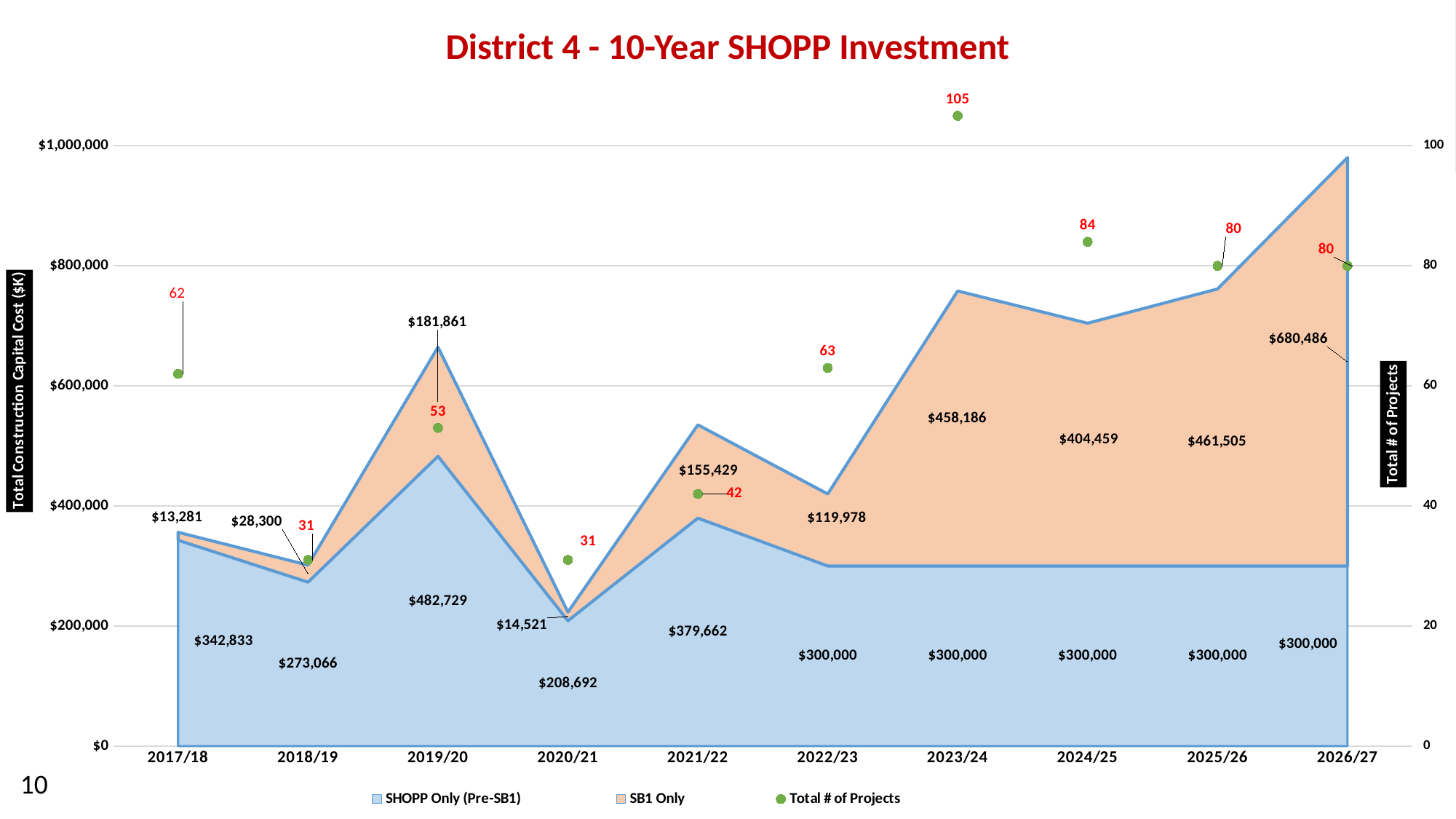
Which year has the highest Total # of Projects? 2023/24 What is the SB1 Only value for 2026/27? $680,486 What is the SHOPP Only (Pre-SB1) value for 2019/20? $482,729 What is the total of SHOPP Only (Pre-SB1) and SB1 Only for 2019/20? $664,590 What kind of chart is used to show the construction capital cost? area chart What is the difference between the SB1 Only values for 2025/26 and 2024/25? $57,046 What is the Total # of Projects for 2023/24? 105 Does the SHOPP Only (Pre-SB1) value rise, fall, or stay the same from 2022/23 to 2026/27? stays the same Which year has the lowest SB1 Only value? 2017/18 How many series does the legend list? 3 Which is larger, the SHOPP Only (Pre-SB1) value for 2017/18 or for 2018/19? 2017/18 How many fiscal years are shown on the x axis? 10